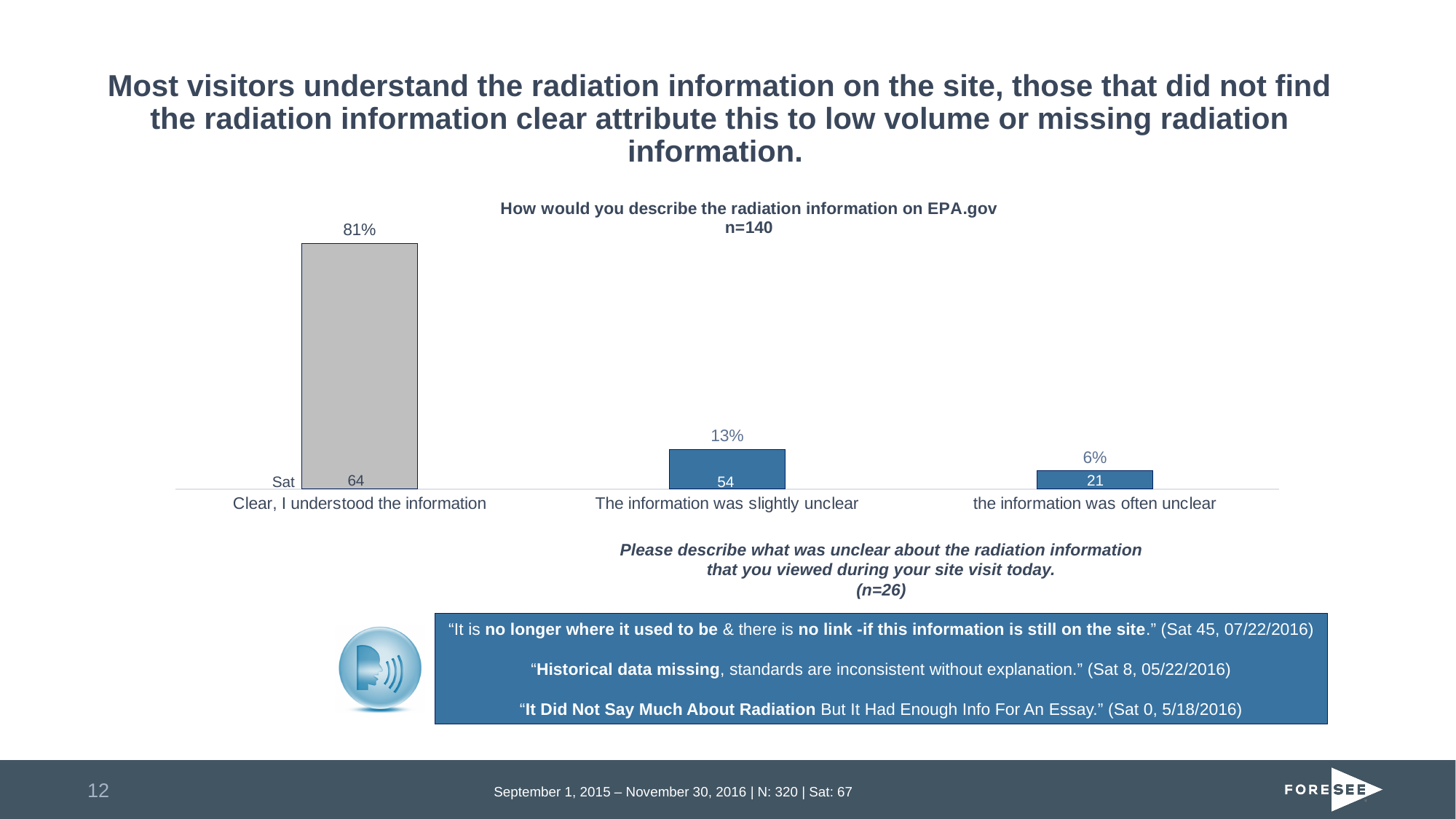
What percentage of respondents said "Clear, I understood the information"? 81% What percentage of respondents said "the information was often unclear"? 6% What is the Sat score shown for "Clear, I understood the information"? 64 How many response categories are shown in the chart? 3 Which has a higher Sat score: "Clear, I understood the information" or "The information was slightly unclear"? Clear, I understood the information What is the Sat score shown for "the information was often unclear"? 21 What is the difference between the Sat scores for "The information was slightly unclear" and "the information was often unclear"? 33 Which response category has the lowest percentage? the information was often unclear What is the difference in percentage points between "Clear, I understood the information" and "The information was slightly unclear"? 68 Which response category has the highest percentage? Clear, I understood the information What type of chart is used to show how visitors describe the radiation information? Bar chart What percentage of respondents said "The information was slightly unclear"? 13%